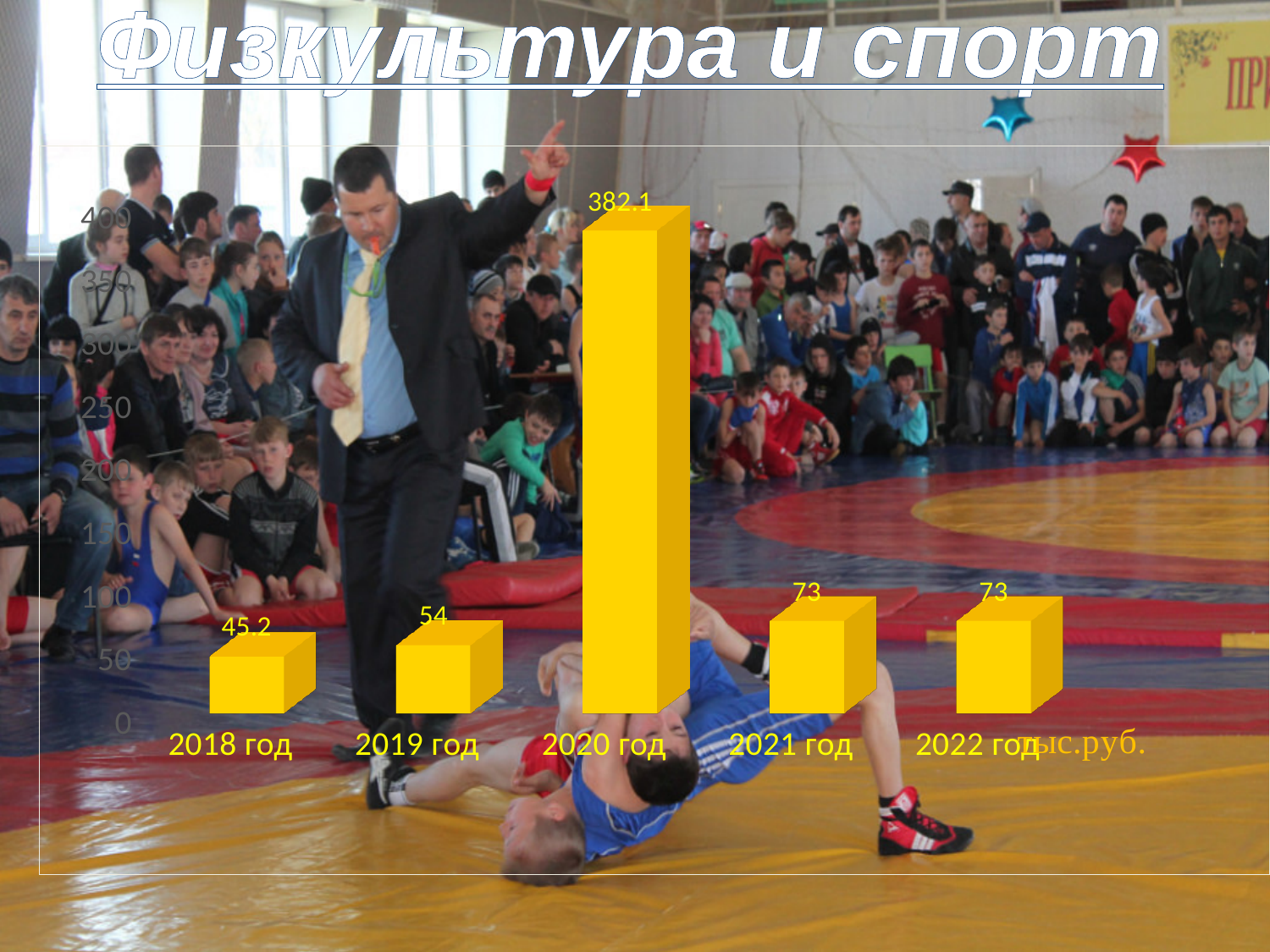
What kind of chart is shown on the slide? bar chart Which year has the highest value? 2020 год Which is larger, the value for 2019 год or the value for 2021 год? 2021 год How many years are shown on the chart? 5 What is the difference between the values for 2019 год and 2018 год? 8.8 What is the value for 2018 год? 45.2 What is the value for 2021 год? 73 What is the title of the slide containing the chart? Физкультура и спорт What is the value for 2020 год? 382.1 What is the value for 2019 год? 54 Which year has the lowest value? 2018 год What is the difference between the values for 2020 год and 2021 год? 309.1